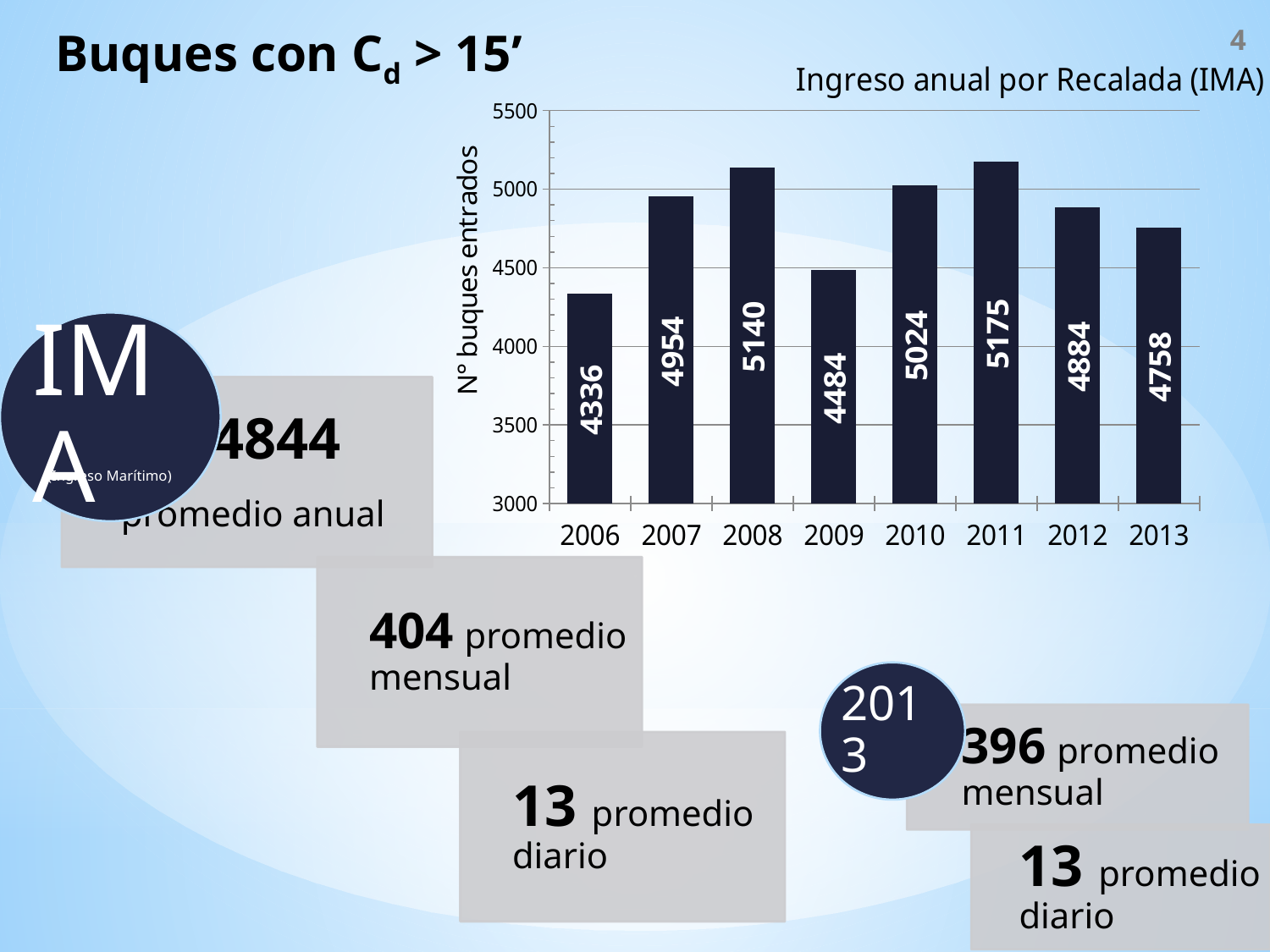
Which year has the highest value in the 'Ingreso anual por Recalada (IMA)' chart? 2011 What is the value for 2011 in the 'Ingreso anual por Recalada (IMA)' chart? 5175 What kind of chart is 'Ingreso anual por Recalada (IMA)'? bar chart Is the value for 2010 in the 'Ingreso anual por Recalada (IMA)' chart greater or less than 5000? greater Does the value rise or fall from 2011 to 2013 in the 'Ingreso anual por Recalada (IMA)' chart? fall Which is larger in the 'Ingreso anual por Recalada (IMA)' chart, the value for 2007 or the value for 2012? 2007 Which year has the lowest value in the 'Ingreso anual por Recalada (IMA)' chart? 2006 What is the value for 2006 in the 'Ingreso anual por Recalada (IMA)' chart? 4336 How many years are shown on the x axis of the 'Ingreso anual por Recalada (IMA)' chart? 8 What is the value for 2013 in the 'Ingreso anual por Recalada (IMA)' chart? 4758 What is the y-axis label of the 'Ingreso anual por Recalada (IMA)' chart? N° buques entrados What is the difference between the values for 2008 and 2009 in the 'Ingreso anual por Recalada (IMA)' chart? 656